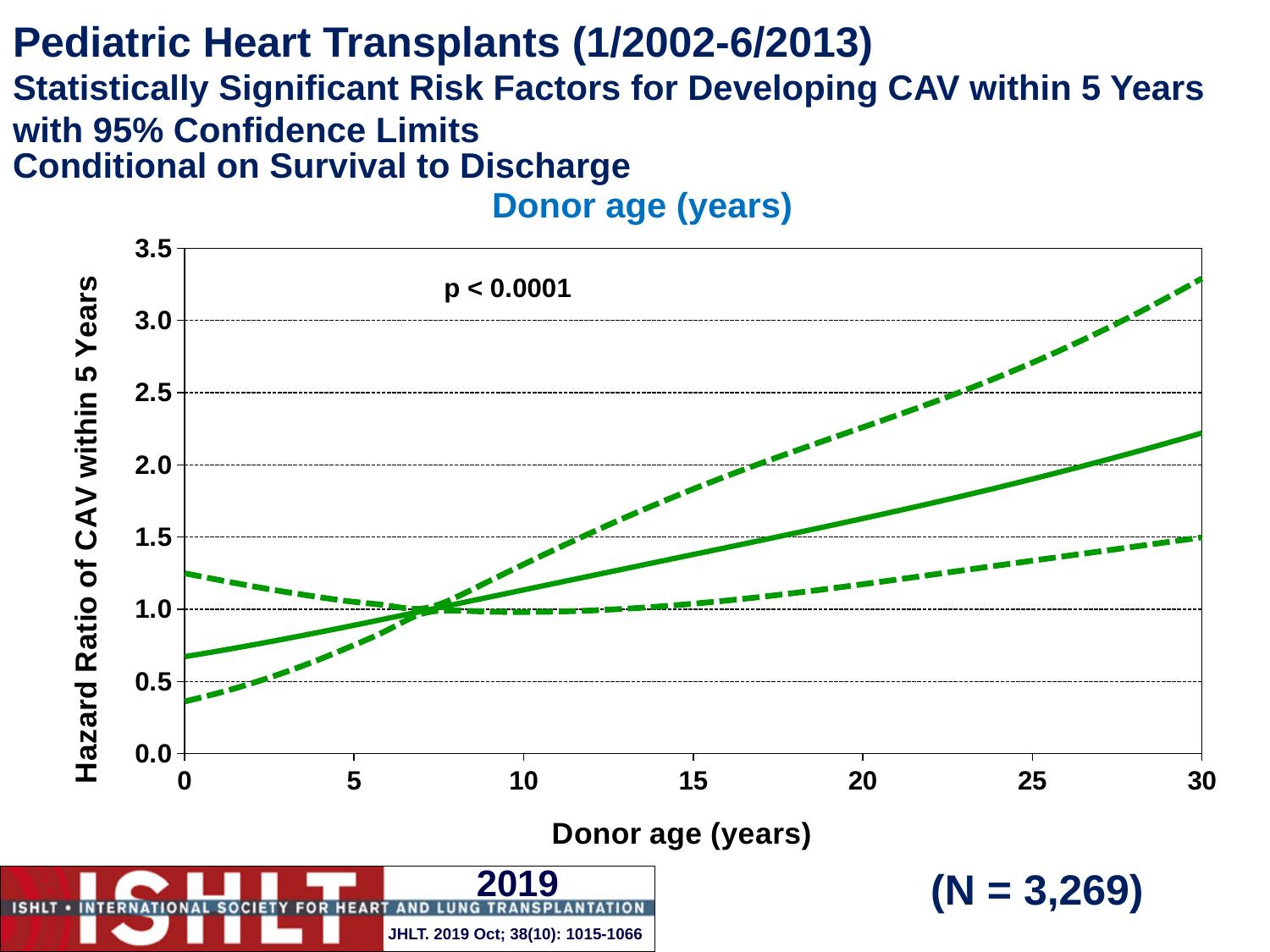
What kind of chart is shown on the slide? line chart Does the upper dashed confidence limit rise or fall as donor age increases from 0 to 30 years? rise How many lines are plotted on the chart? 3 Is the value of the upper dashed confidence limit at donor age 30 greater or less than 3.0? greater Does the solid hazard ratio line rise or fall as donor age increases from 0 to 30 years? rise What p-value is printed on the chart? p < 0.0001 What sample size (N) is shown on the slide? N = 3,269 Is the value of the solid hazard ratio line at donor age 0 greater or less than 1.0? less Is the value of the solid hazard ratio line at donor age 20 greater or less than 1.5? greater